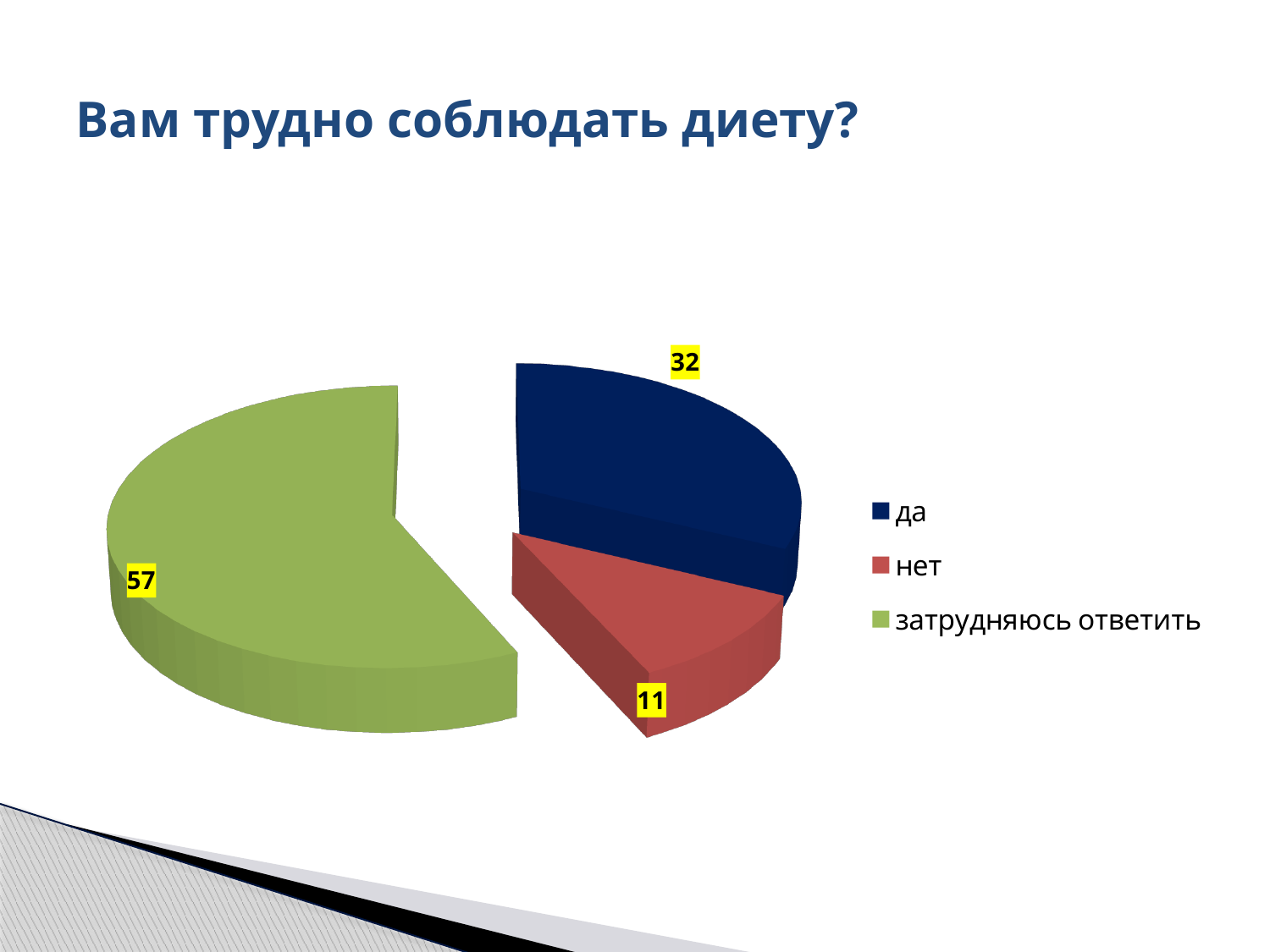
Which category has the largest slice? затрудняюсь ответить What type of chart is shown on the slide? pie chart How many categories does the pie chart have? 3 What is the value for "нет"? 11 What is the title of the slide? Вам трудно соблюдать диету? What share of the pie does "затрудняюсь ответить" represent? 57% What is the value for "затрудняюсь ответить"? 57 Which is larger, the value for "да" or the value for "нет"? да What is the value for "да"? 32 What is the difference between the values for "затрудняюсь ответить" and "да"? 25 What is the difference between the values for "да" and "нет"? 21 Which category has the smallest slice? нет